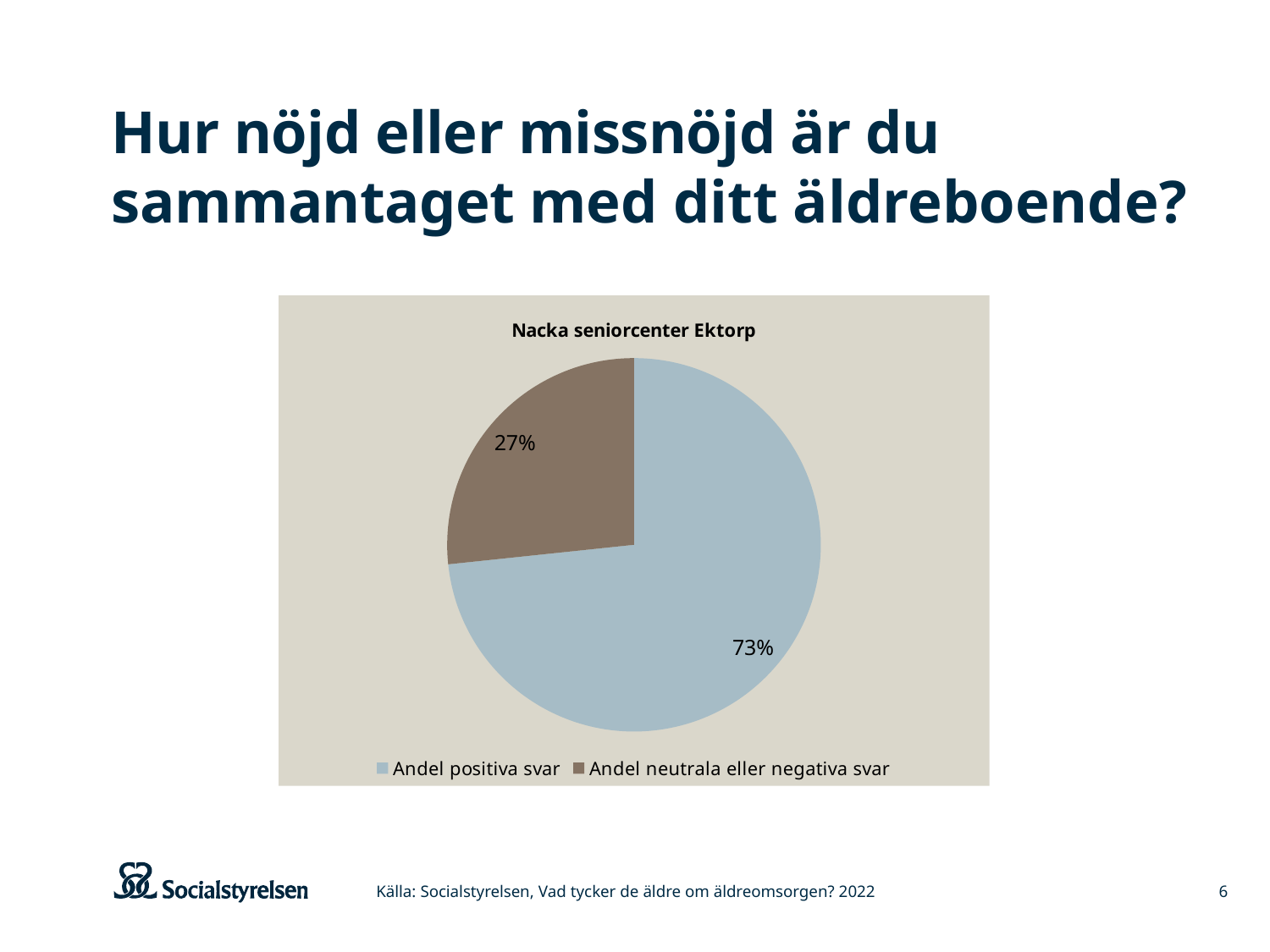
What is the title of the chart? Nacka seniorcenter Ektorp What is the difference between Andel positiva svar and Andel neutrala eller negativa svar? 46% What share of the pie does Andel positiva svar take? 73% What kind of chart is shown on the slide? pie chart What is the value for Andel neutrala eller negativa svar? 27% Which slice is the largest? Andel positiva svar How many slices does the pie chart have? 2 How many entries does the legend list? 2 What colour is the slice for Andel neutrala eller negativa svar? brown What is the value for Andel positiva svar? 73% Which is larger, Andel positiva svar or Andel neutrala eller negativa svar? Andel positiva svar Which slice is the smallest? Andel neutrala eller negativa svar